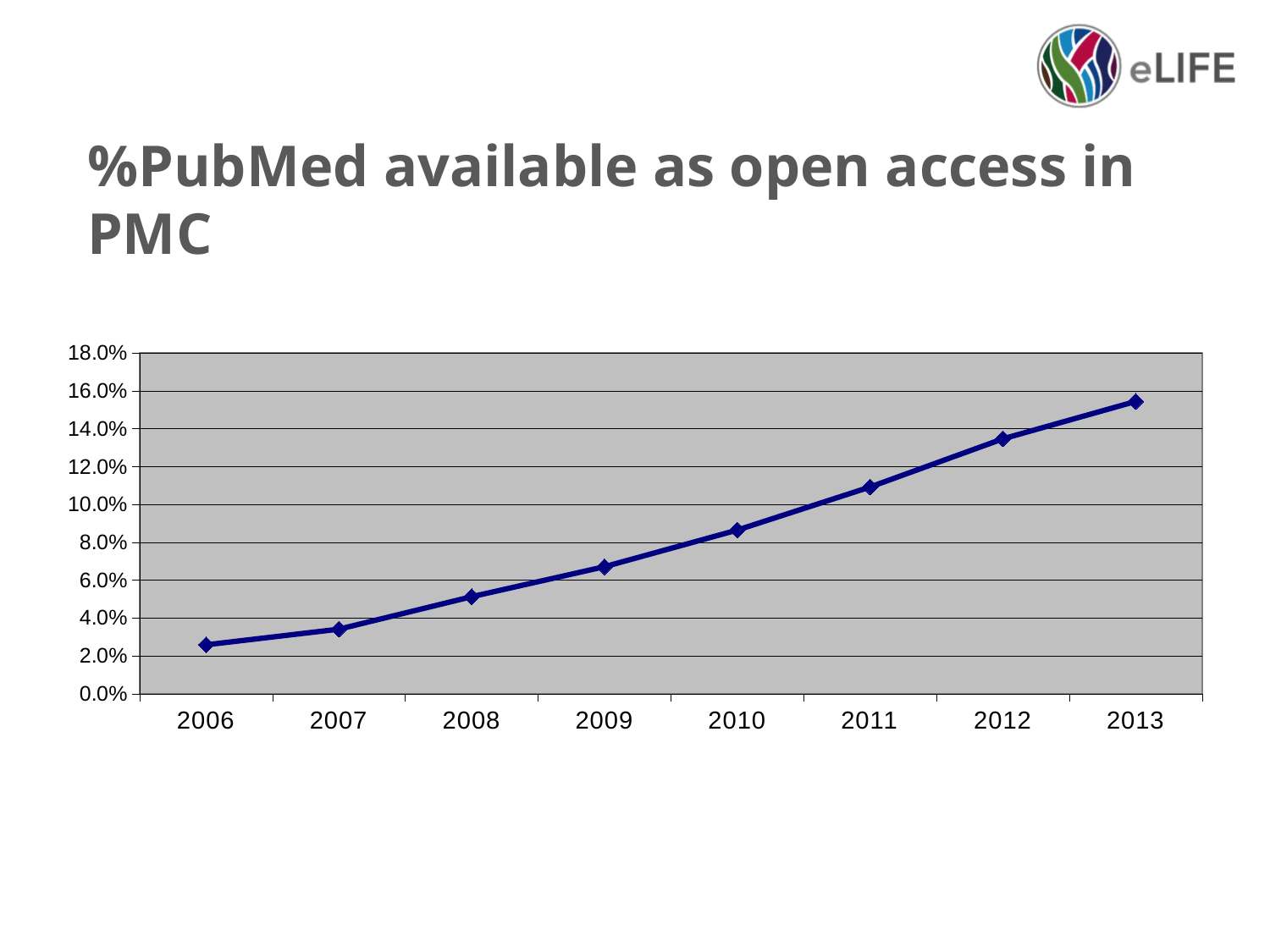
What is the highest value shown on the y axis? 18.0% Do the values rise or fall from 2006 to 2013? Rise What kind of chart is shown on the slide? Line chart Is the value for 2012 greater or less than 12.0%? greater Which year has the lowest value in the chart? 2006 Is the value for 2009 greater or less than 8.0%? less Is the value for 2013 greater or less than 14.0%? greater What is the title of the slide containing the chart? %PubMed available as open access in PMC Which year has the highest value in the chart? 2013 How many years are plotted on the x axis? 8 Which is larger, the value for 2011 or the value for 2008? 2011